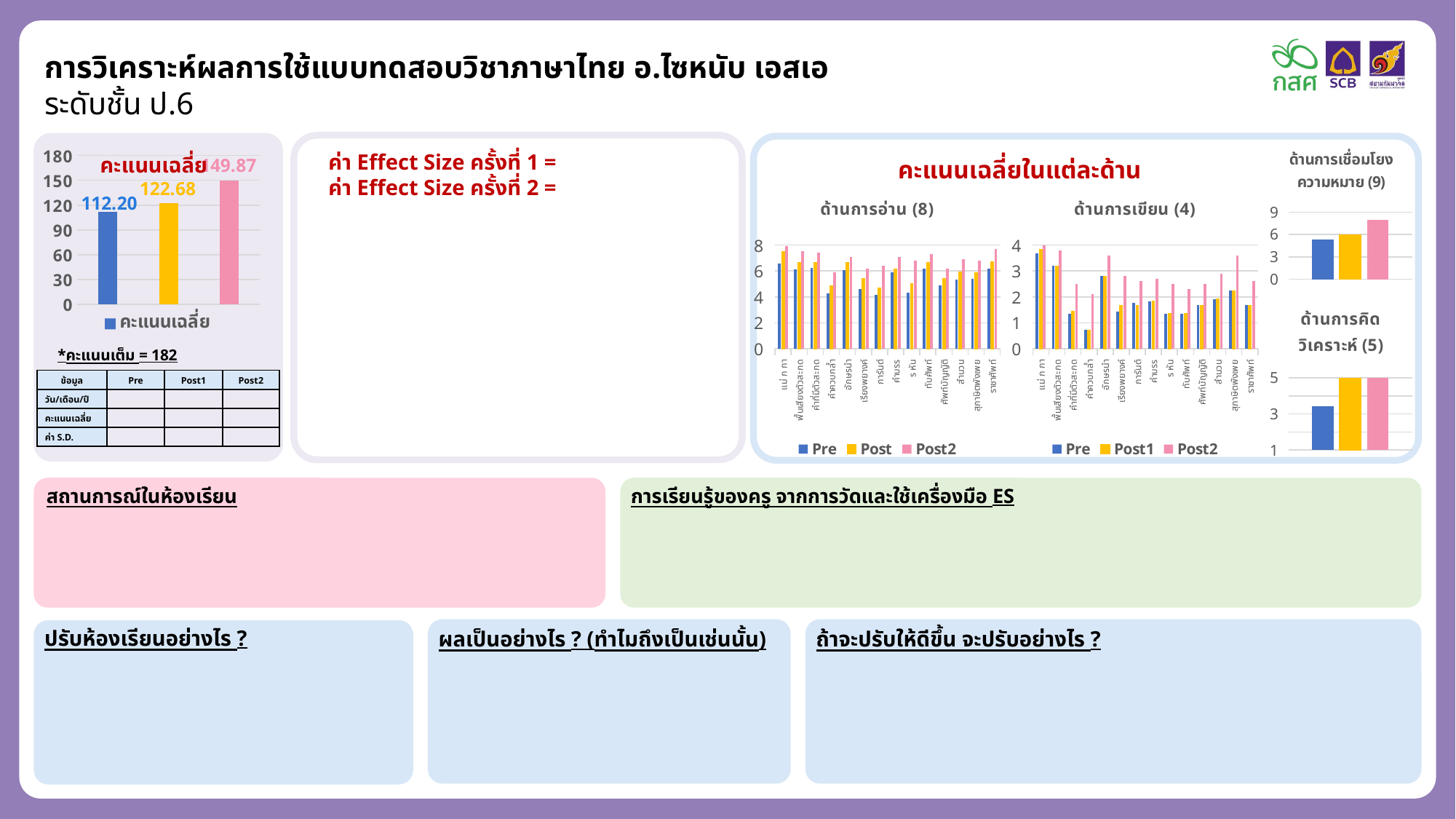
What is the full score noted below the 'คะแนนเฉลี่ย' chart on the left? 182 In the 'ด้านการเชื่อมโยงความหมาย (9)' chart, which bar is the highest? The pink bar In the 'ด้านการอ่าน (8)' chart, how many series does the legend list? 3 In the 'ด้านการคิดวิเคราะห์ (5)' chart, which bar is the lowest? The blue bar In the 'ด้านการคิดวิเคราะห์ (5)' chart, is the value of the blue bar greater or less than 3? greater What kind of chart is the 'คะแนนเฉลี่ย' chart on the left of the slide? Bar chart In the 'ด้านการเชื่อมโยงความหมาย (9)' chart, is the value of the pink bar greater or less than 6? greater In the 'คะแนนเฉลี่ย' bar chart on the left, which bar is the highest? The pink (third) bar In the 'คะแนนเฉลี่ย' bar chart on the left, what value is labelled on the yellow bar? 122.68 In the 'คะแนนเฉลี่ย' bar chart on the left, what value is labelled on the blue bar? 112.20 In the 'คะแนนเฉลี่ย' bar chart on the left, what is the difference between the yellow bar (122.68) and the blue bar (112.20)? 10.48 In the 'ด้านการเขียน (4)' chart, what are the legend entries? Pre, Post1, Post2